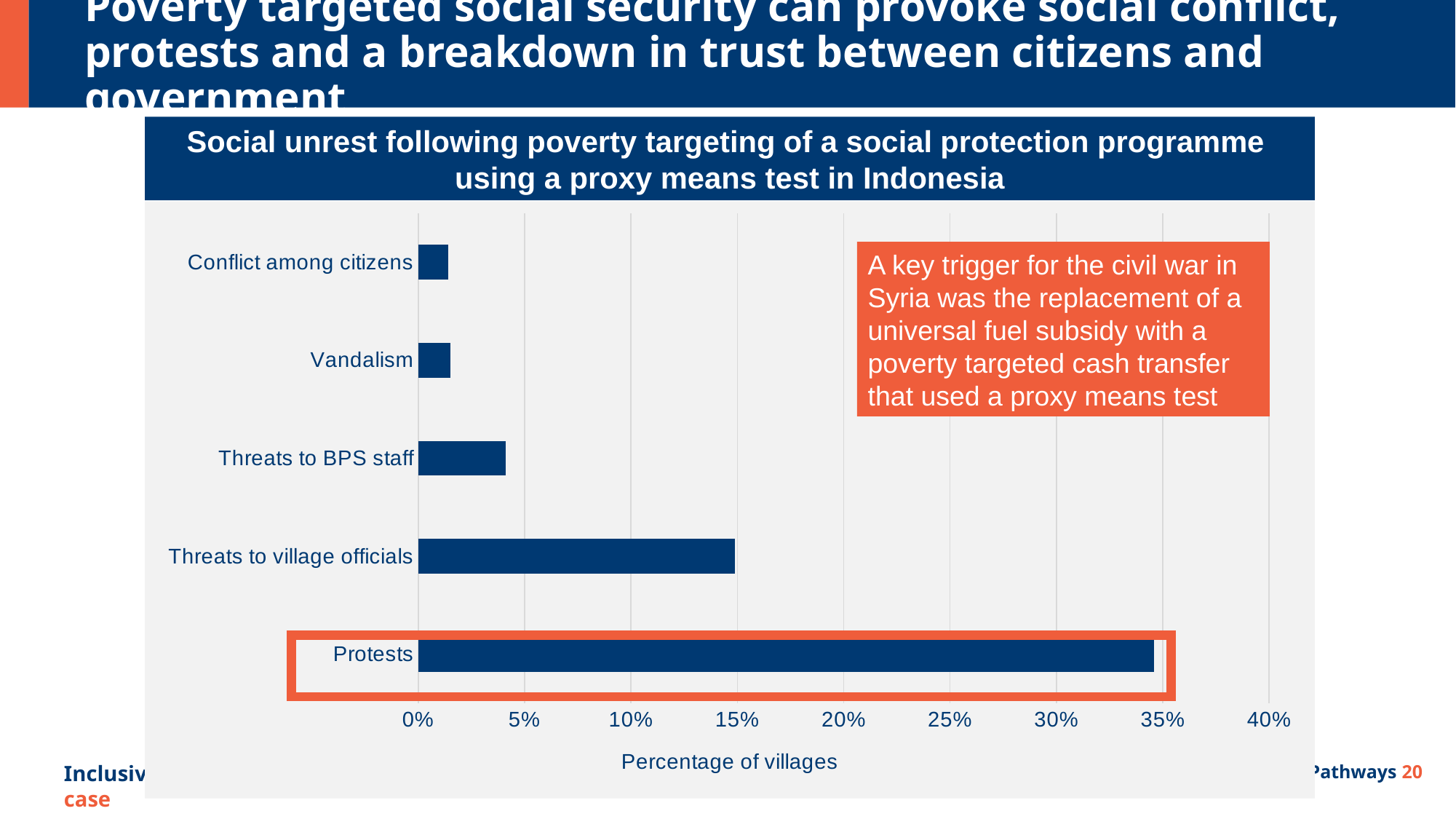
Which is larger, the value for Threats to BPS staff or the value for Vandalism? Threats to BPS staff Is the value for Protests greater or less than 40%? less Is the value for Protests greater or less than 30%? greater What is the title of the chart? Social unrest following poverty targeting of a social protection programme using a proxy means test in Indonesia How many categories are plotted in the chart? 5 What kind of chart is shown on the slide? bar chart Which category has the highest percentage of villages? Protests Is the value for Threats to village officials greater or less than 10%? greater What is the label of the horizontal axis of the chart? Percentage of villages Which is larger, the value for Protests or the value for Threats to village officials? Protests